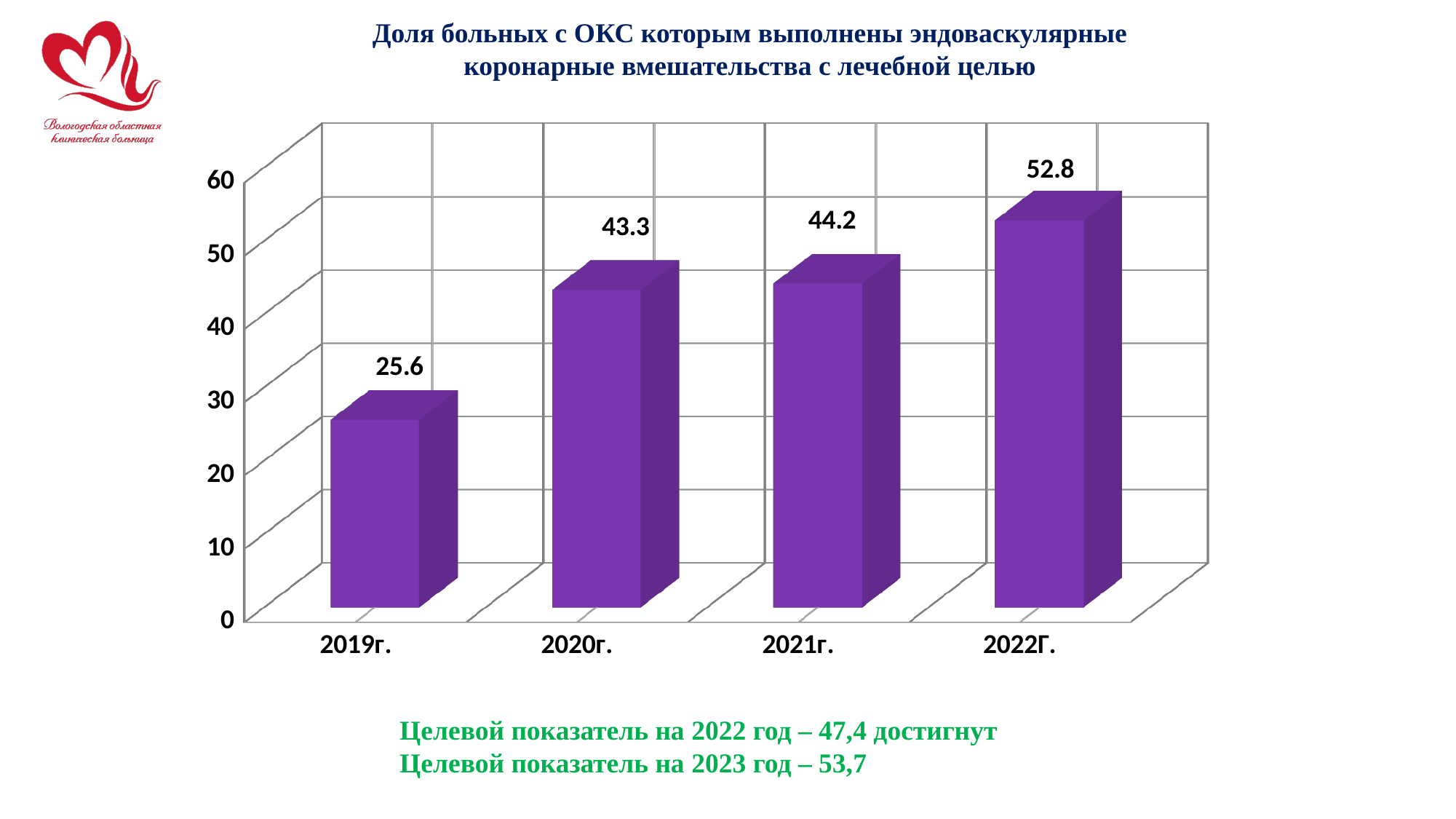
Which year has the lowest value? 2019г. What is the value for 2022Г.? 52.8 Which year has the highest value? 2022Г. Which is larger, the value for 2019г. or the value for 2022Г.? 2022Г. How many years are shown on the x axis? 4 What is the value for 2019г.? 25.6 What kind of chart is shown on the slide? bar chart What is the difference between the values for 2022Г. and 2019г.? 27.2 Do the values rise or fall from 2019г. to 2022Г.? rise What is the value for 2020г.? 43.3 What is the difference between the values for 2021г. and 2020г.? 0.9 What is the value for 2021г.? 44.2